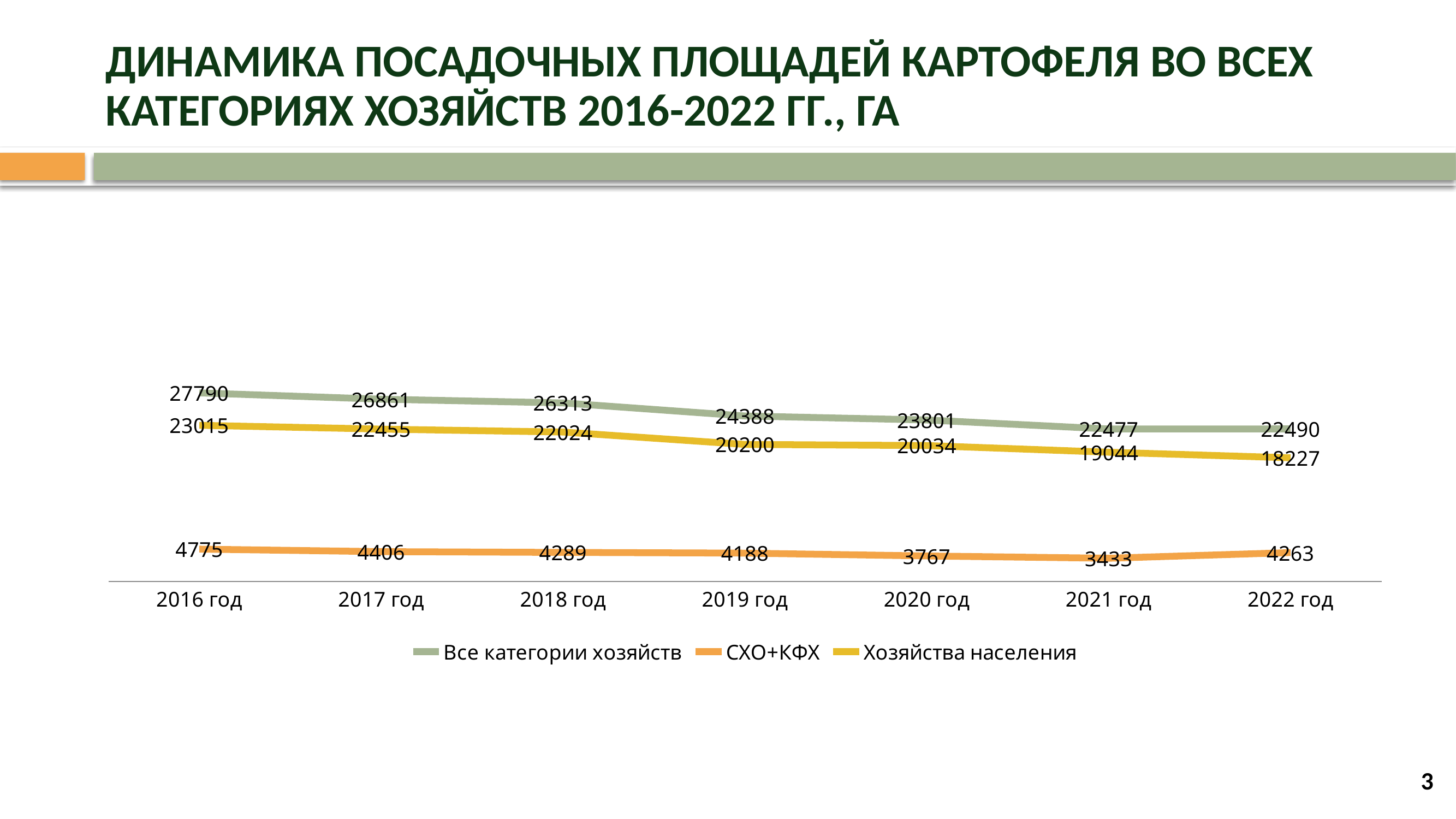
What is the value for 'Хозяйства населения' in 2022 год? 18227 What kind of chart is shown on the slide? line chart How many series does the legend list? 3 Which series is drawn in orange? СХО+КФХ Which is larger: the 'СХО+КФХ' value in 2016 год or in 2022 год? 2016 год How many years are shown on the x axis? 7 What is the value for 'СХО+КФХ' in 2021 год? 3433 In which year is the value for 'Хозяйства населения' highest? 2016 год Do the values for 'Все категории хозяйств' generally rise or fall from 2016 год to 2022 год? fall In which year is the value for 'СХО+КФХ' lowest? 2021 год What is the value for 'Все категории хозяйств' in 2016 год? 27790 What is the difference between the 'Все категории хозяйств' values in 2016 год and 2022 год? 5300